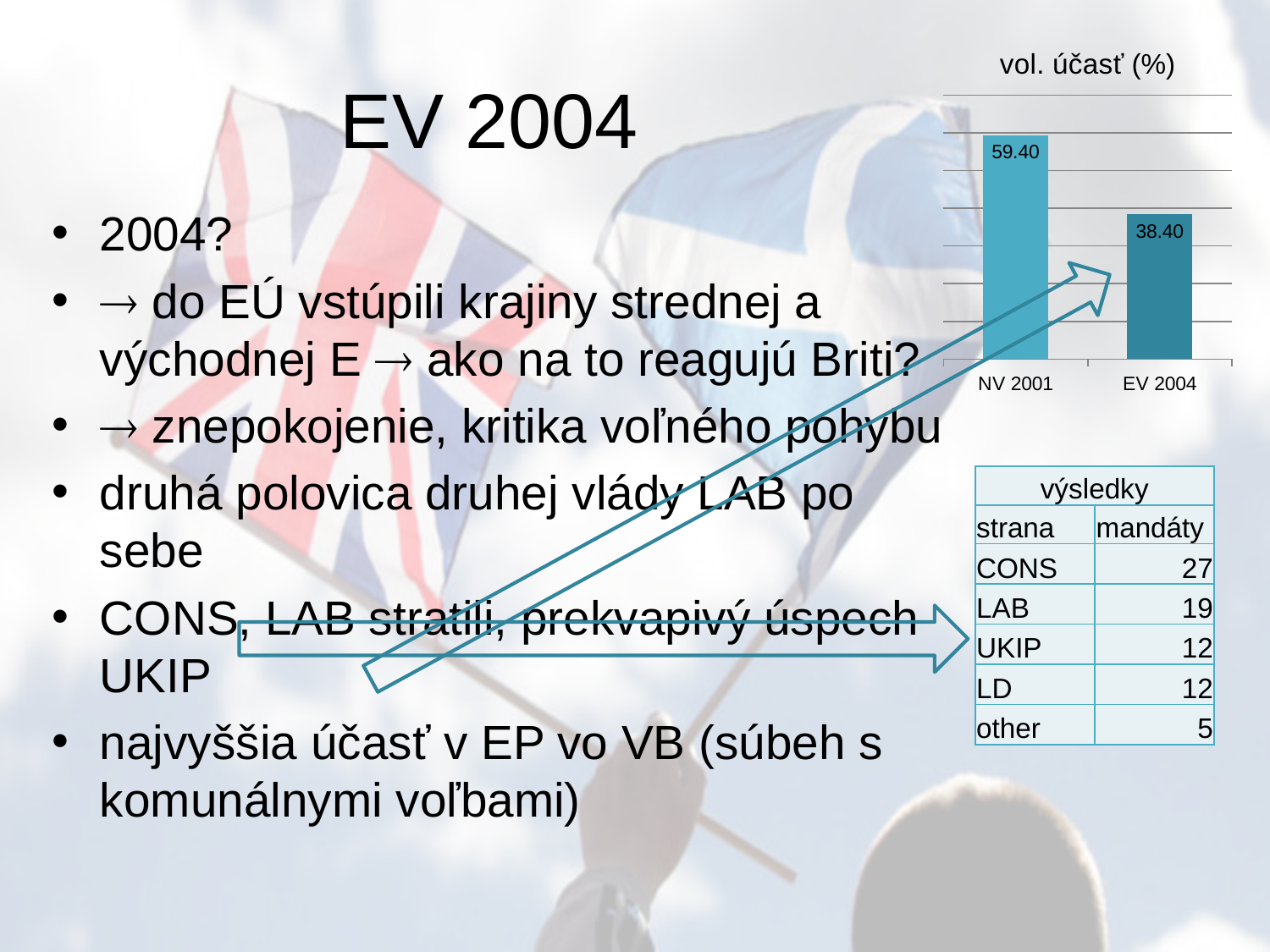
Which category has the highest value in the chart? NV 2001 What kind of chart is shown on the slide? bar chart Which is larger, the value for NV 2001 or the value for EV 2004? NV 2001 What is the value for EV 2004 in the chart? 38.40 What is the difference between the values for NV 2001 and EV 2004? 21.00 What is the value for NV 2001 in the chart? 59.40 What is the title of the chart? vol. účasť (%) How many categories are shown in the chart? 2 Do the values rise or fall from NV 2001 to EV 2004? fall Which category has the lowest value in the chart? EV 2004